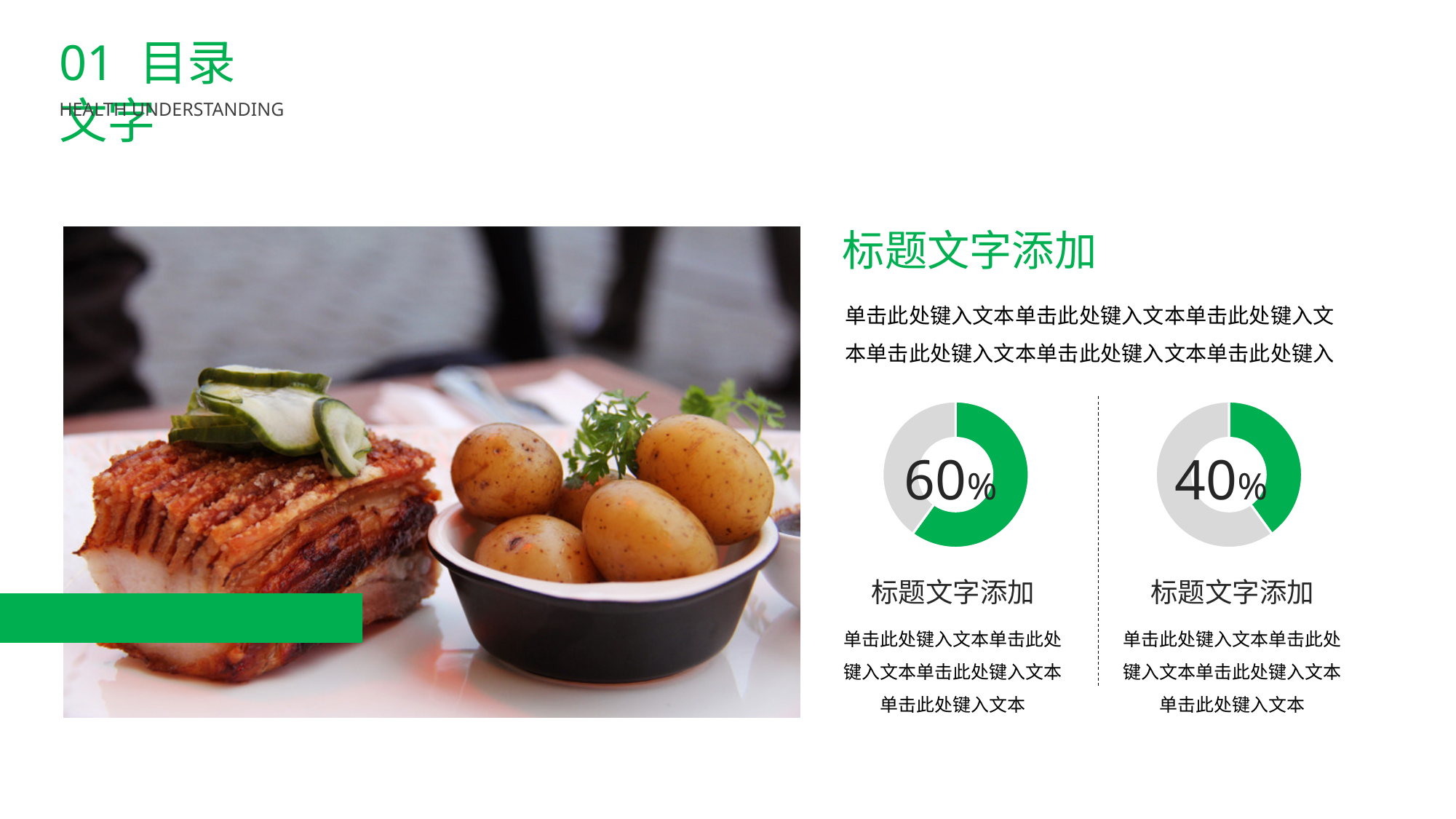
In the left donut chart, what share of the ring is filled in green? 60% How many donut charts are on the slide? 2 Which donut chart shows the larger percentage, the left one or the right one? the left one In the right donut chart, what share of the ring is filled in green? 40% What percentage is shown in the left donut chart? 60% What is the difference between the percentage in the left donut chart and the percentage in the right donut chart? 20 percentage points What kind of chart is used to display the 60% and 40% values on the slide? donut (pie) chart What percentage is shown in the right donut chart? 40% Is the value shown in the right donut chart greater or less than 50%? less What colour is used for the unfilled remainder of the donut charts? grey What colour is used for the filled portion of the donut charts? green Is the value shown in the left donut chart greater or less than 50%? greater